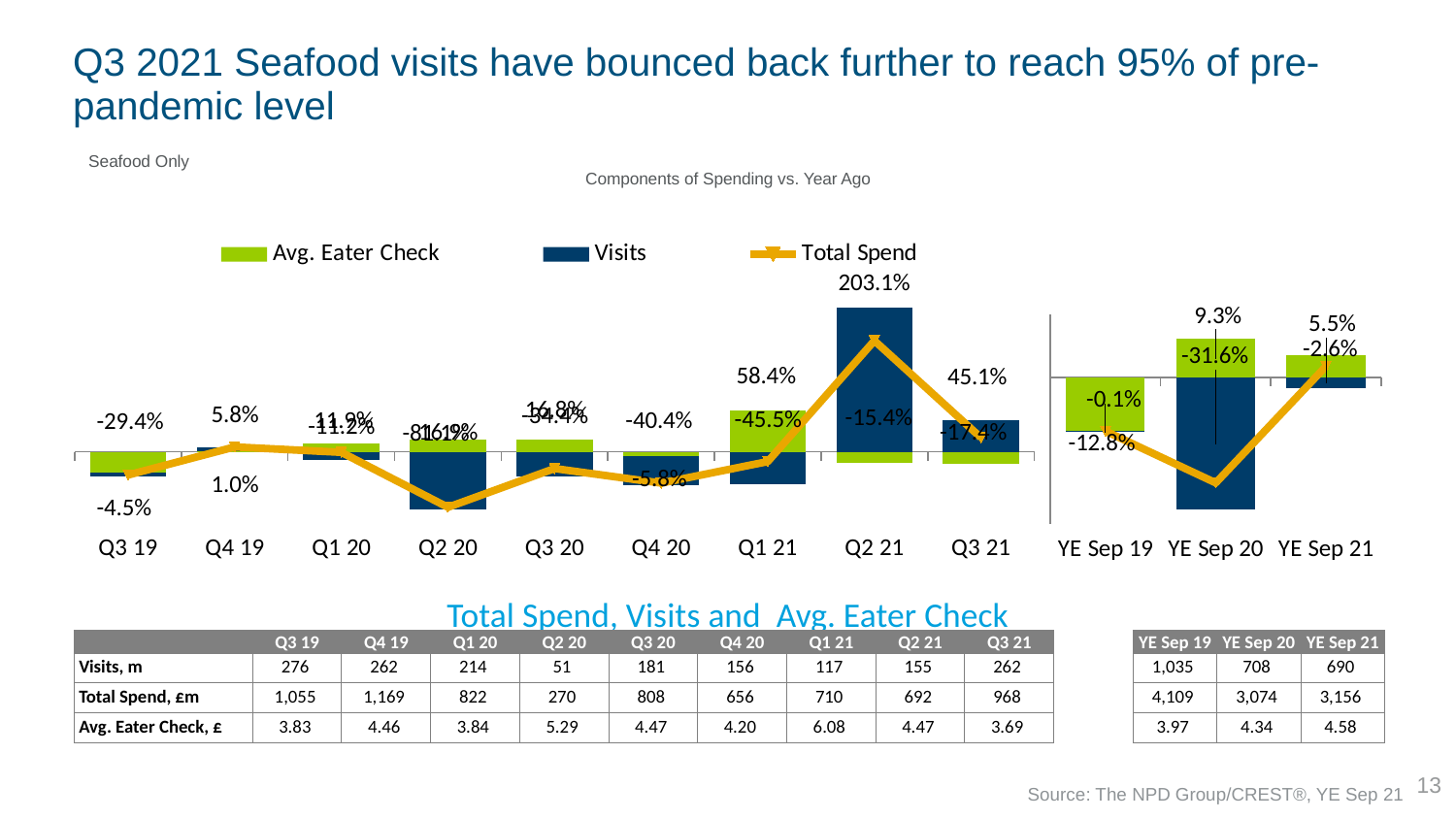
On the left chart (Components of Spending vs. Year Ago), which quarter has the lowest Visits bar? Q2 20 On the right chart (YE Sep), what is the Visits value for YE Sep 20? -31.6% On the right chart (YE Sep), is the Visits value for YE Sep 20 greater or less than the Visits value for YE Sep 21? less How many series does the legend list for the Components of Spending vs. Year Ago chart? 3 On the left chart (Components of Spending vs. Year Ago), which quarter has the highest Visits bar? Q2 21 On the left chart (Components of Spending vs. Year Ago), what is the Visits value for Q3 21? 45.1% On the left chart (Components of Spending vs. Year Ago), what is the Visits value for Q2 21? 203.1% How many quarters are shown on the x axis of the left chart (Components of Spending vs. Year Ago)? 9 On the left chart (Components of Spending vs. Year Ago), what is the Avg. Eater Check value for Q2 21? -15.4% In the legend of the Components of Spending vs. Year Ago chart, which series is shown as an orange line? Total Spend On the right chart (YE Sep), what is the Avg. Eater Check value for YE Sep 21? 5.5% On the left chart (Components of Spending vs. Year Ago), what is the Avg. Eater Check value for Q1 21? 58.4%